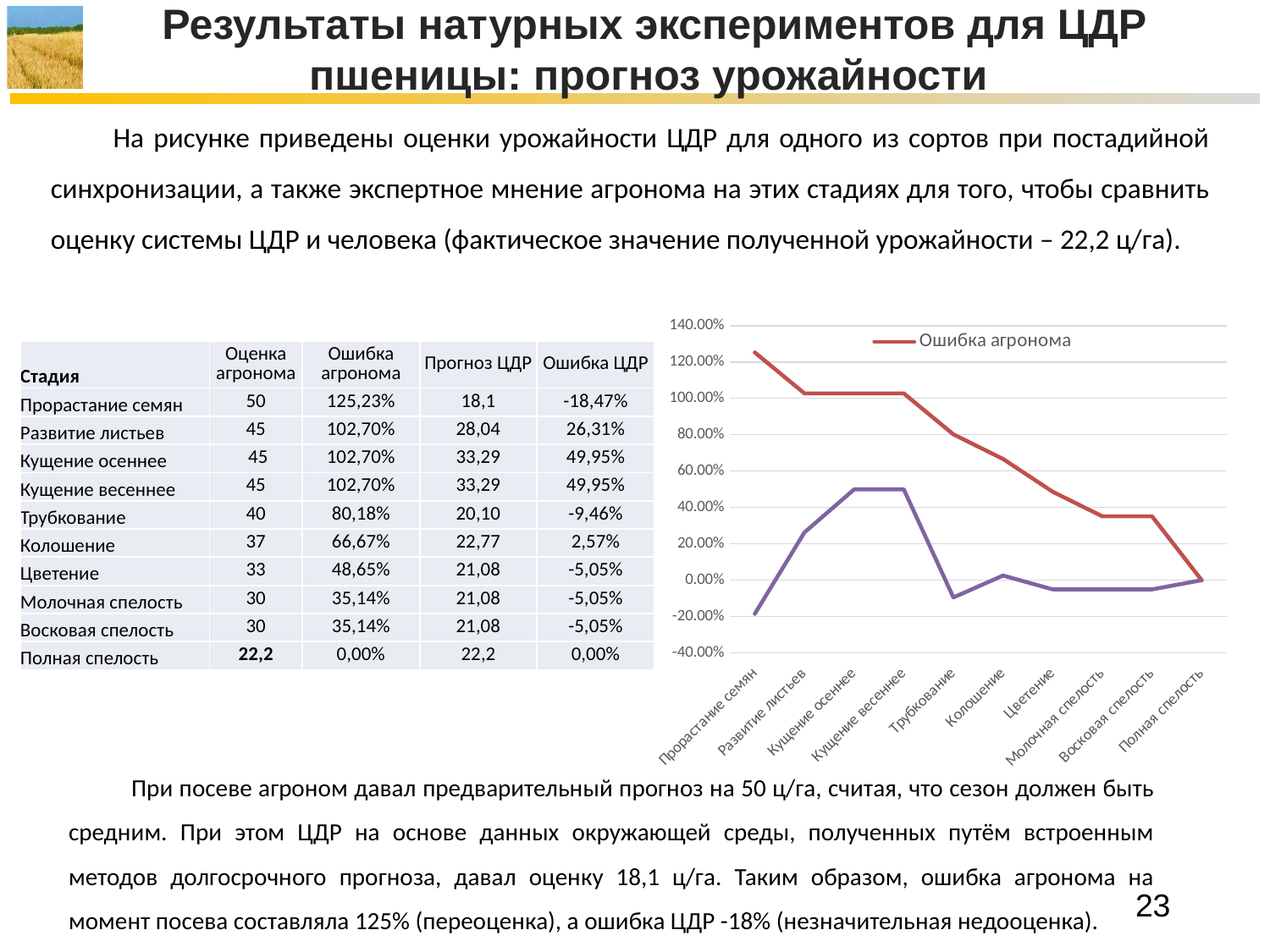
Is the value of the purple line at 'Прорастание семян' greater or less than 0.00%? less Is the value of 'Ошибка агронома' at 'Трубкование' greater or less than 100.00%? less At which stage is the 'Ошибка агронома' line highest? Прорастание семян What is the value of 'Ошибка агронома' at the stage 'Прорастание семян'? 125,23% How many stages (categories) are plotted along the x axis of the chart? 10 What kind of chart is shown on the slide? line chart At the stage 'Кущение осеннее', which line is higher: the red 'Ошибка агронома' line or the purple line? the red 'Ошибка агронома' line What is the value of 'Ошибка агронома' at the stage 'Колошение'? 66,67% At which stage is the 'Ошибка агронома' line lowest? Полная спелость Does the 'Ошибка агронома' line rise or fall from 'Прорастание семян' to 'Полная спелость'? fall What is the difference between 'Ошибка агронома' at 'Прорастание семян' and at 'Трубкование'? 45,05% Which series name is shown in the chart legend? Ошибка агронома